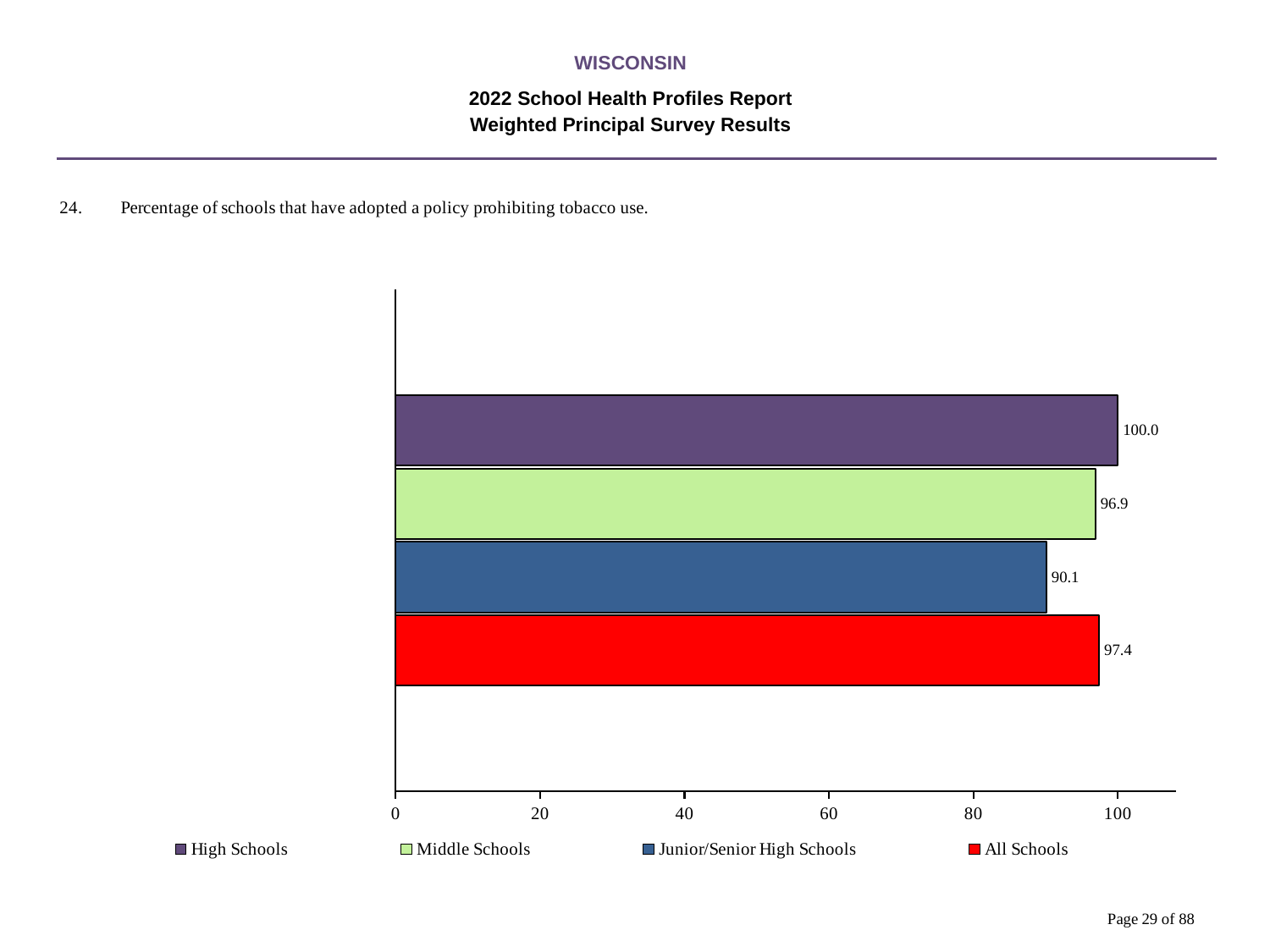
Which is larger, the value for Middle Schools or the value for Junior/Senior High Schools? Middle Schools What is the difference between the values for All Schools and Middle Schools? 0.5 How many series does the legend list? 4 What is the value for Junior/Senior High Schools? 90.1 Which school type has the highest value? High Schools What kind of chart is shown on the slide? Bar chart What is the value for High Schools? 100.0 What is the value for All Schools? 97.4 What is the value for Middle Schools? 96.9 What colour is the bar for All Schools? Red Which school type has the lowest value? Junior/Senior High Schools What is the difference between the values for High Schools and Junior/Senior High Schools? 9.9